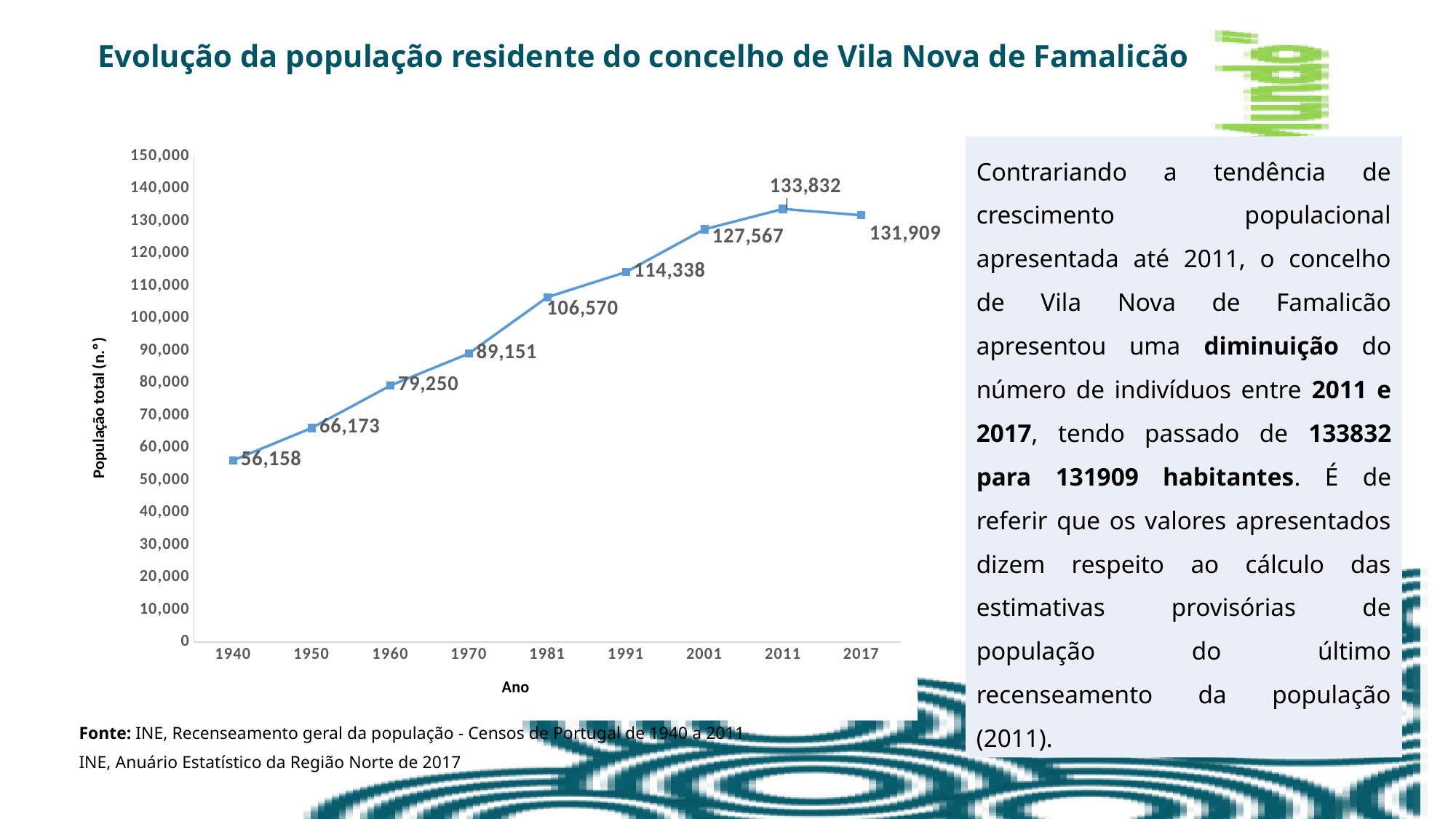
What was the resident population of Vila Nova de Famalicão in 1940? 56,158 How many years (data points) are plotted on the chart? 9 In which year was the resident population highest? 2011 Which year had a larger population, 1991 or 2001? 2001 What is the difference between the population in 1950 and in 1940? 10,015 What is the label of the y axis of the chart? População total (n.º) What type of chart is shown on the slide? line chart What was the resident population in 1981? 106,570 Does the population rise or fall between 1940 and 2011? rise What was the resident population in 2017? 131,909 What is the difference between the population in 2011 and in 2017? 1,923 In which year was the resident population lowest? 1940